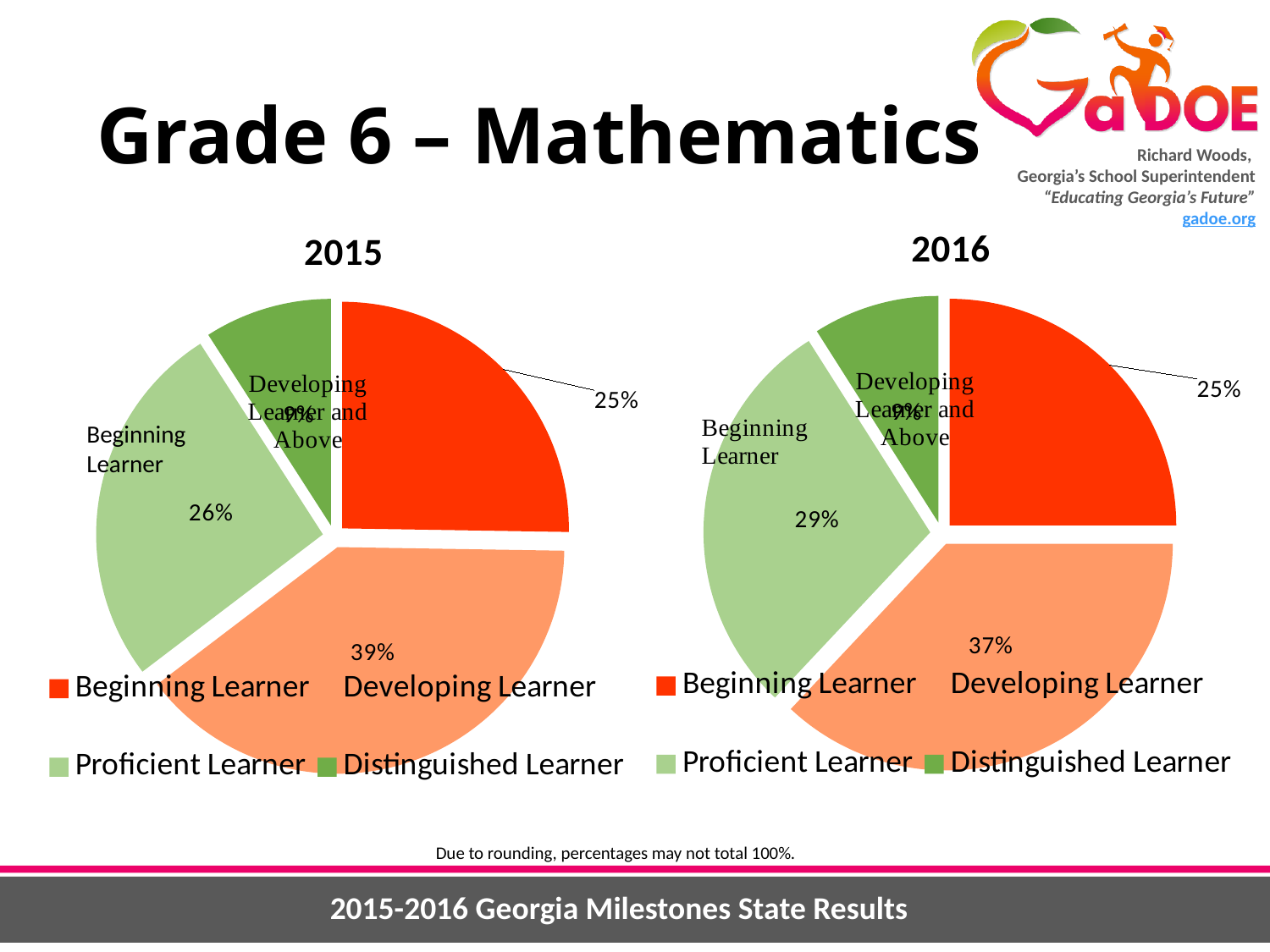
In the 2016 pie chart, what percentage is shown for Proficient Learner? 29% In the 2015 pie chart, what percentage is shown for Beginning Learner? 25% In the 2016 pie chart, which category has the smallest share? Distinguished Learner What is the difference between the Proficient Learner percentages in the 2016 and 2015 pie charts? 3% How many categories does the legend of the 2015 pie chart list? 4 What type of chart is used for the 2016 data? Pie chart In the 2015 pie chart, what percentage is shown for Developing Learner? 39% Which is larger in the 2016 pie chart: Beginning Learner or Proficient Learner? Proficient Learner What colour represents Beginning Learner in the legends of both charts? Red What is the difference between the Developing Learner percentages in the 2015 and 2016 pie charts? 2% In the 2016 pie chart, what percentage is shown for Developing Learner? 37% In the 2015 pie chart, which category has the largest share? Developing Learner